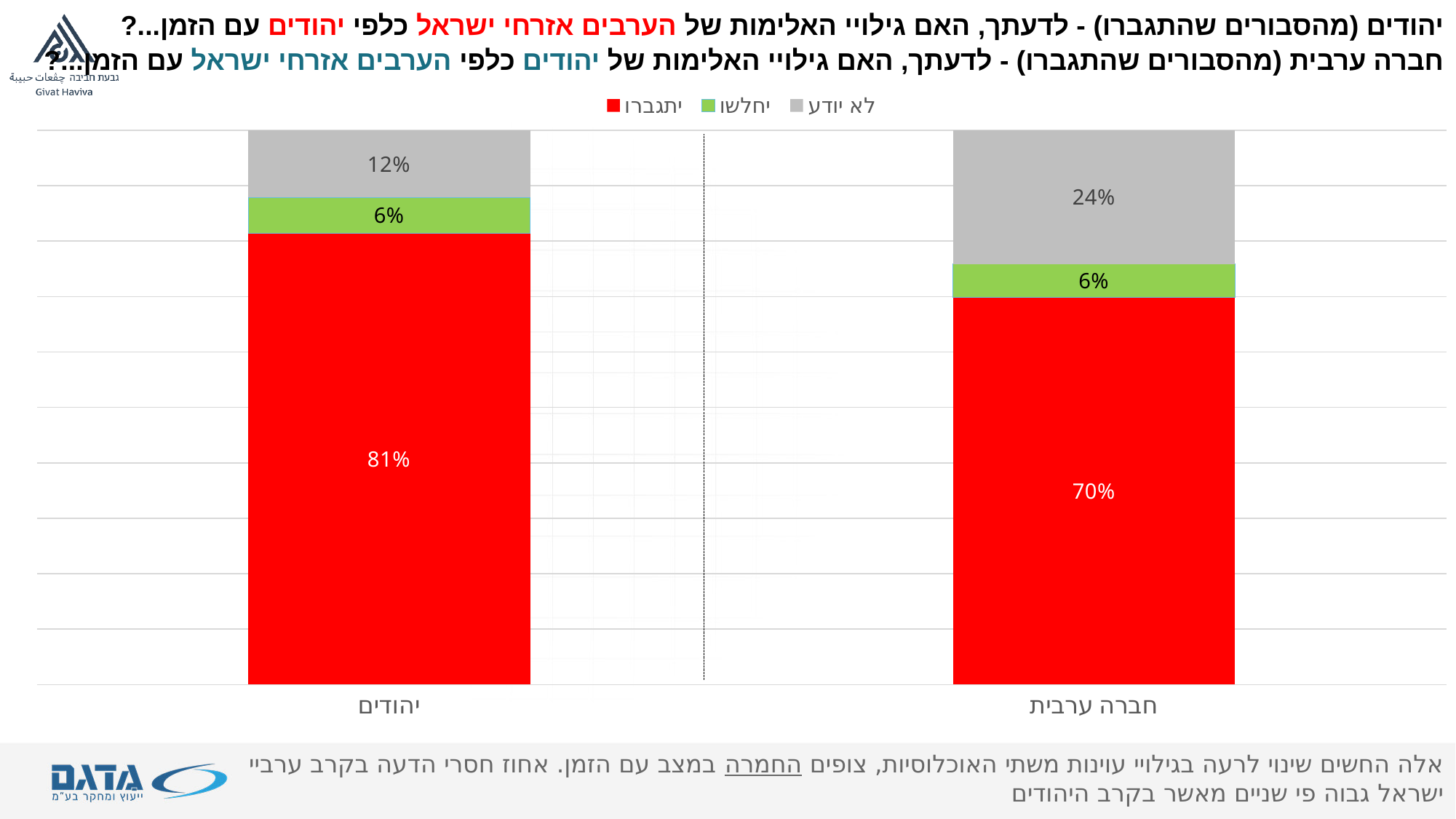
Which category has the lower value for לא יודע? יהודים What is the value of לא יודע for יהודים? 12% What is the value of יתגברו for חברה ערבית? 70% Which category has the higher value for יתגברו? יהודים Which series is shown in red in the legend? יתגברו How many series does the legend list? 3 What is the value of יתגברו for יהודים? 81% What is the value of יחלשו for יהודים? 6% What is the value of לא יודע for חברה ערבית? 24% What kind of chart is shown on the slide? stacked bar chart What is the difference between the לא יודע values for חברה ערבית and יהודים? 12% How many categories are shown on the x axis? 2